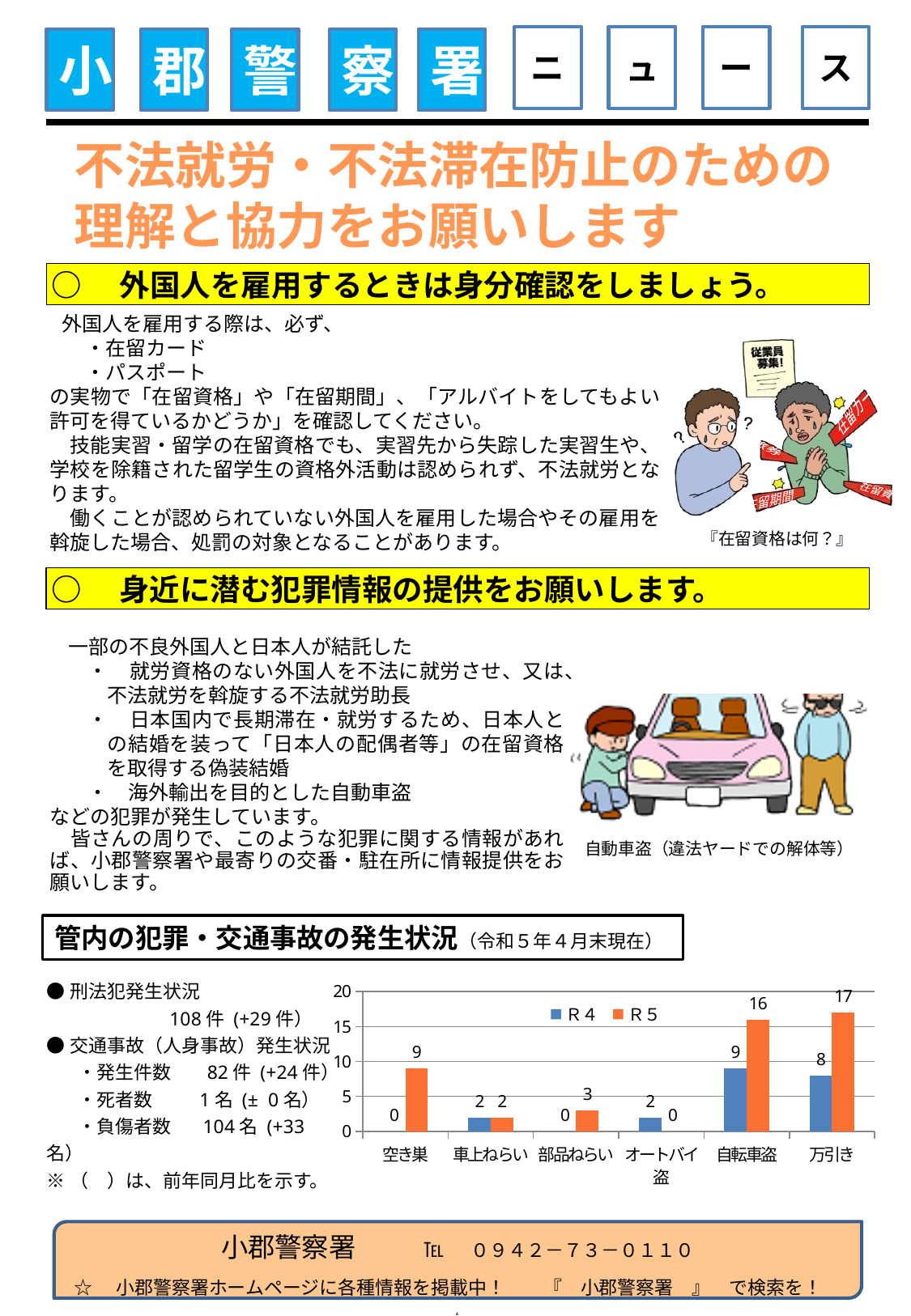
How many series does the chart legend list? 2 Which category has the highest R5 value in the chart? 万引き Which is larger for オートバイ盗, the R4 value or the R5 value? R4 What is the difference between the R5 and R4 values for 万引き? 9 What kind of chart is shown on the slide? Bar chart What is the difference between the R5 and R4 values for 自転車盗? 7 What is the R5 value for 空き巣 in the chart? 9 How many categories are shown on the x axis of the chart? 6 What is the R5 value for 万引き in the chart? 17 Which is larger for 部品ねらい, the R4 value or the R5 value? R5 What is the R4 value for 自転車盗 in the chart? 9 Which category has the highest R4 value in the chart? 自転車盗